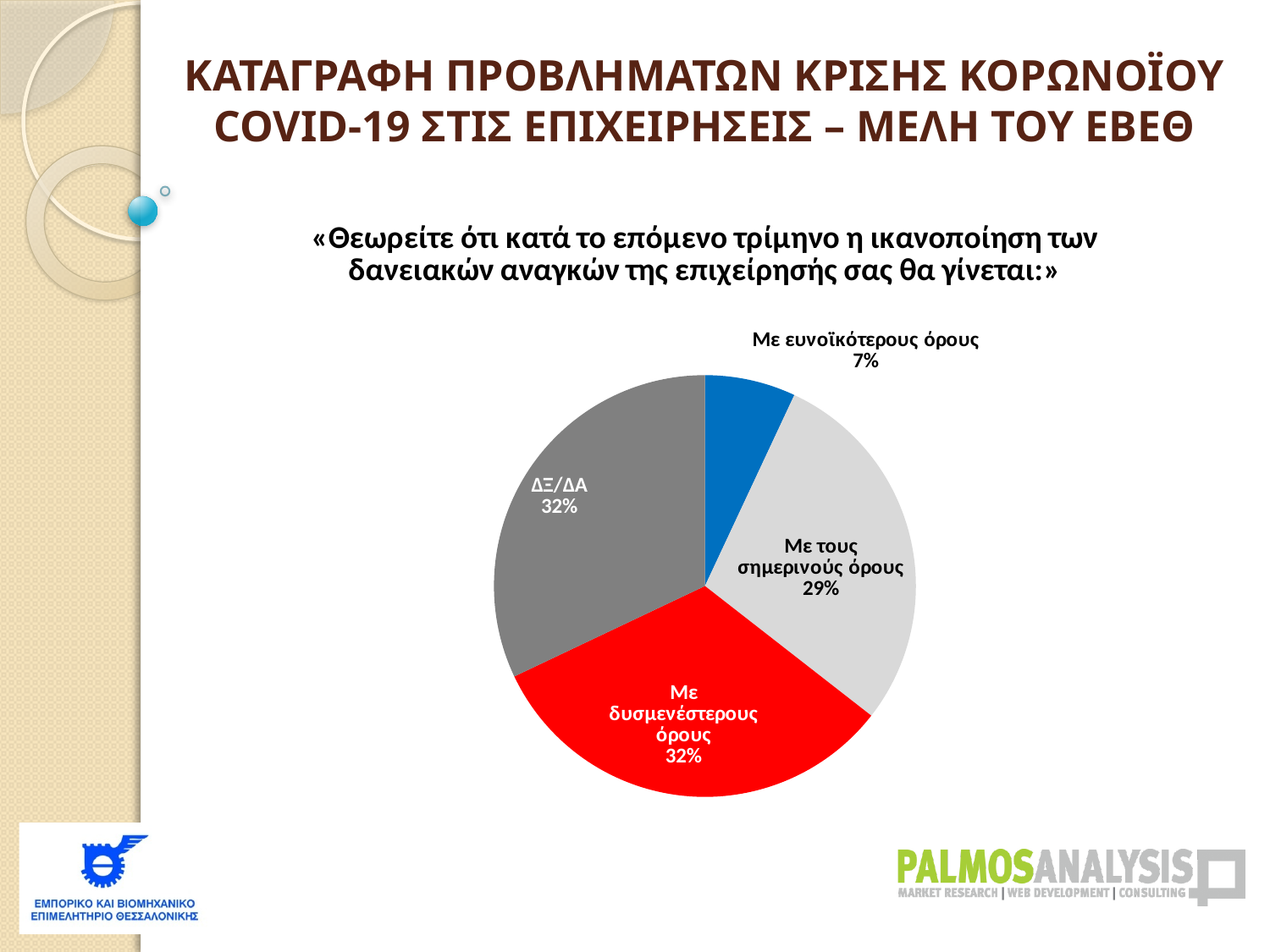
What colour is the slice for "Με ευνοϊκότερους όρους"? Blue What colour is the slice for "Με δυσμενέστερους όρους"? Red What percentage is shown for the "ΔΞ/ΔΑ" slice? 32% Which response has the smallest share of the pie? Με ευνοϊκότερους όρους What percentage of respondents answered "Με δυσμενέστερους όρους"? 32% Which is larger: the share for "Με δυσμενέστερους όρους" or the share for "Με τους σημερινούς όρους"? Με δυσμενέστερους όρους What percentage of respondents answered "Με ευνοϊκότερους όρους"? 7% What percentage of respondents answered "Με τους σημερινούς όρους"? 29% How many slices does the pie chart have? 4 What is the difference in percentage points between "Με τους σημερινούς όρους" and "Με ευνοϊκότερους όρους"? 22 What type of chart is shown on the slide? Pie chart What is the difference in percentage points between "Με δυσμενέστερους όρους" and "Με ευνοϊκότερους όρους"? 25